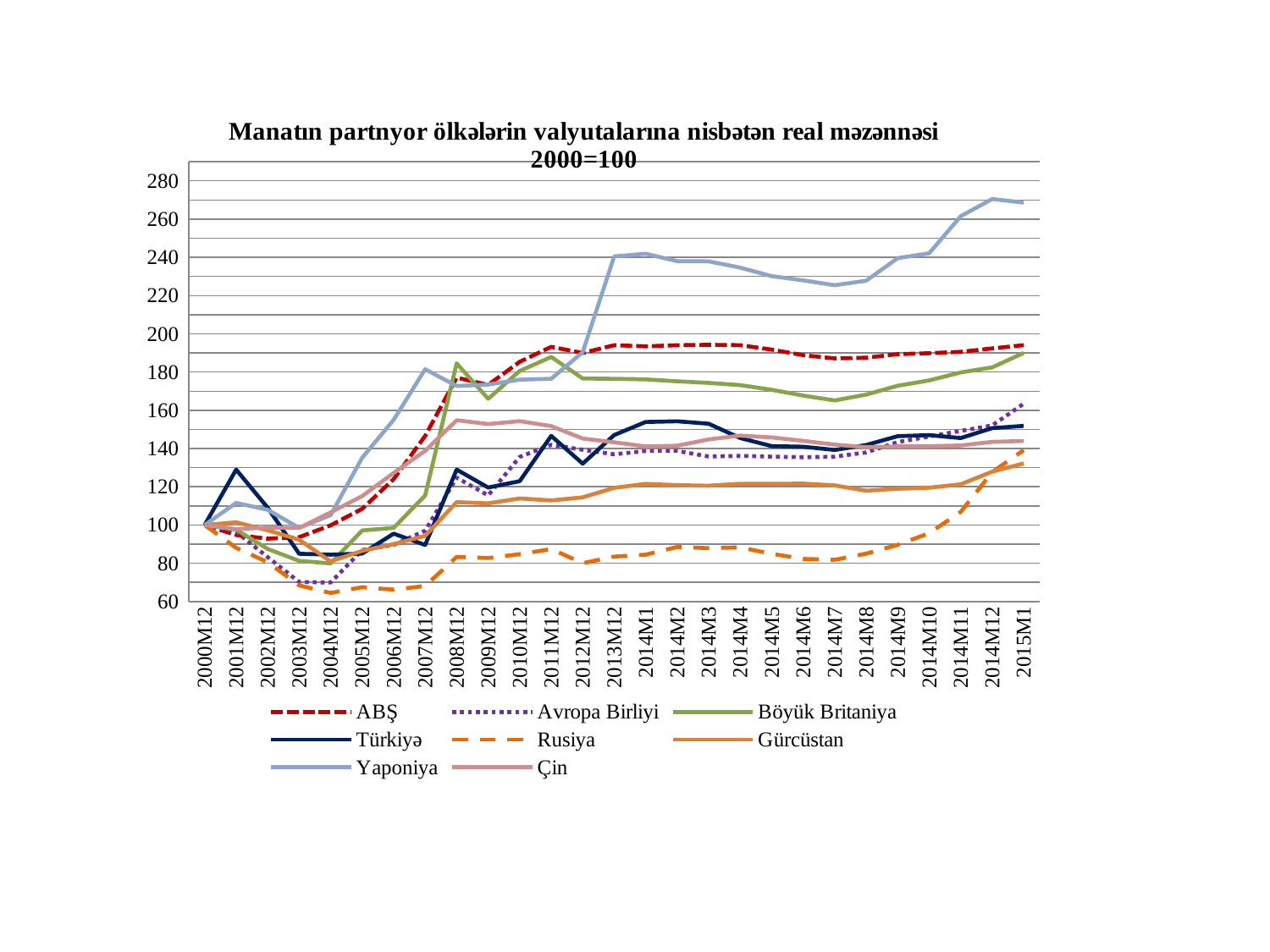
Is the value for Böyük Britaniya at 2014M7 greater or less than 180? less Which series has the highest value at 2015M1? Yaponiya What is the value for ABŞ at 2000M12? 100 At 2014M6, which is higher: Yaponiya or ABŞ? Yaponiya What base value is stated in the chart title? 2000=100 Is the value for Rusiya at 2004M12 greater or less than 80? less How many points are on the x axis of the chart? 27 How many series does the legend list? 8 Does the Yaponiya line rise or fall from 2014M7 to 2014M12? rises Is the value for Yaponiya at 2015M1 greater or less than 260? greater Which series has the lowest value at 2014M1? Rusiya What kind of chart is shown on the slide? line chart